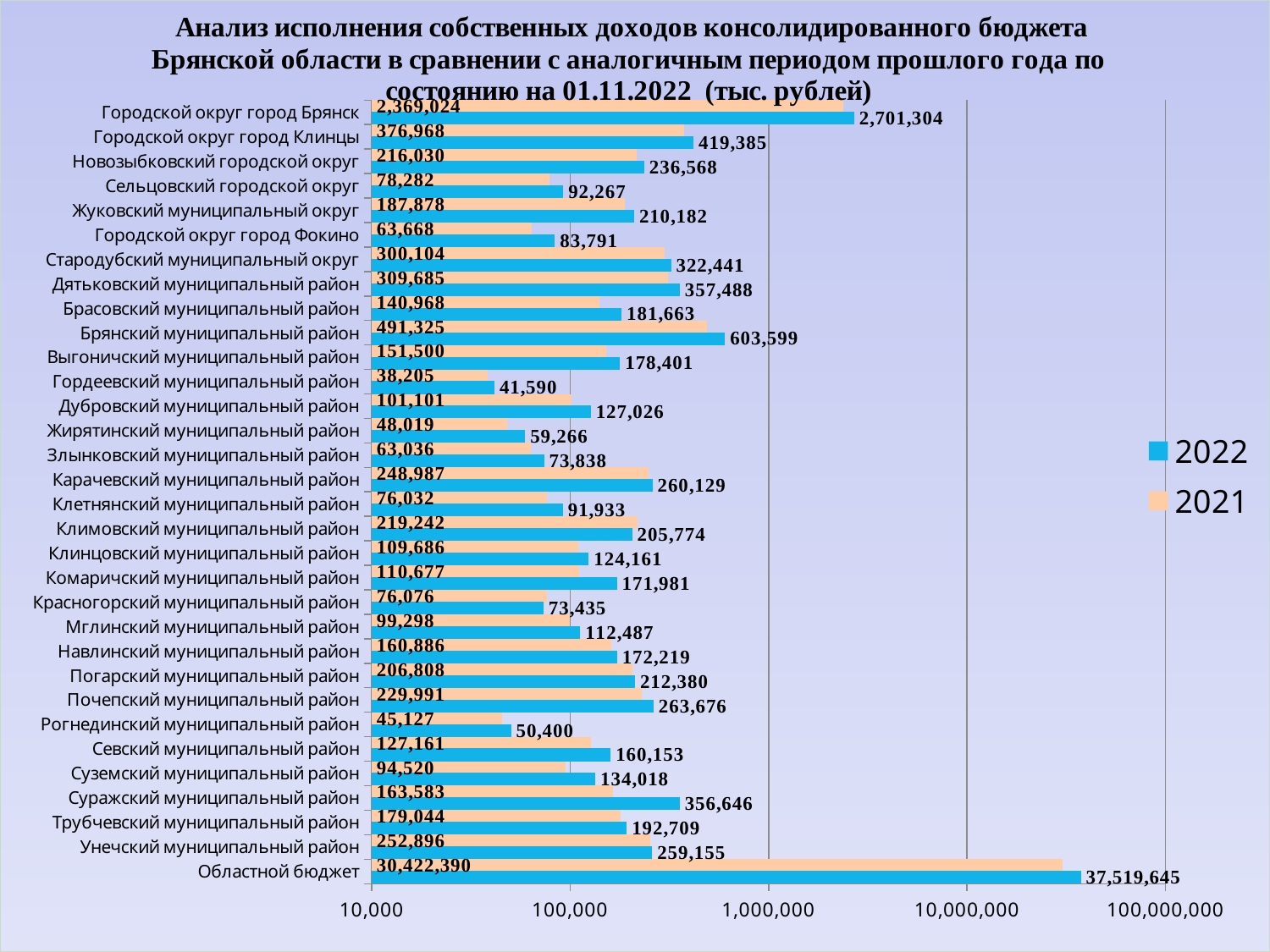
Is the 2022 value for Суражский муниципальный район greater or less than 100,000? greater What is the 2022 value for Брянский муниципальный район? 603,599 Which category has the highest 2022 value? Областной бюджет How many categories are shown on the chart? 32 What is the difference between the 2022 and 2021 values for Городской округ город Брянск? 332,280 What is the 2022 value for Областной бюджет? 37,519,645 What is the difference between the 2022 and 2021 values for Суражский муниципальный район? 193,063 For Климовский муниципальный район, which year has the larger value, 2022 or 2021? 2021 What kind of chart is shown on the slide? Bar chart How many series does the legend list? 2 What is the 2021 value for Гордеевский муниципальный район? 38,205 Which category has the lowest 2022 value? Гордеевский муниципальный район